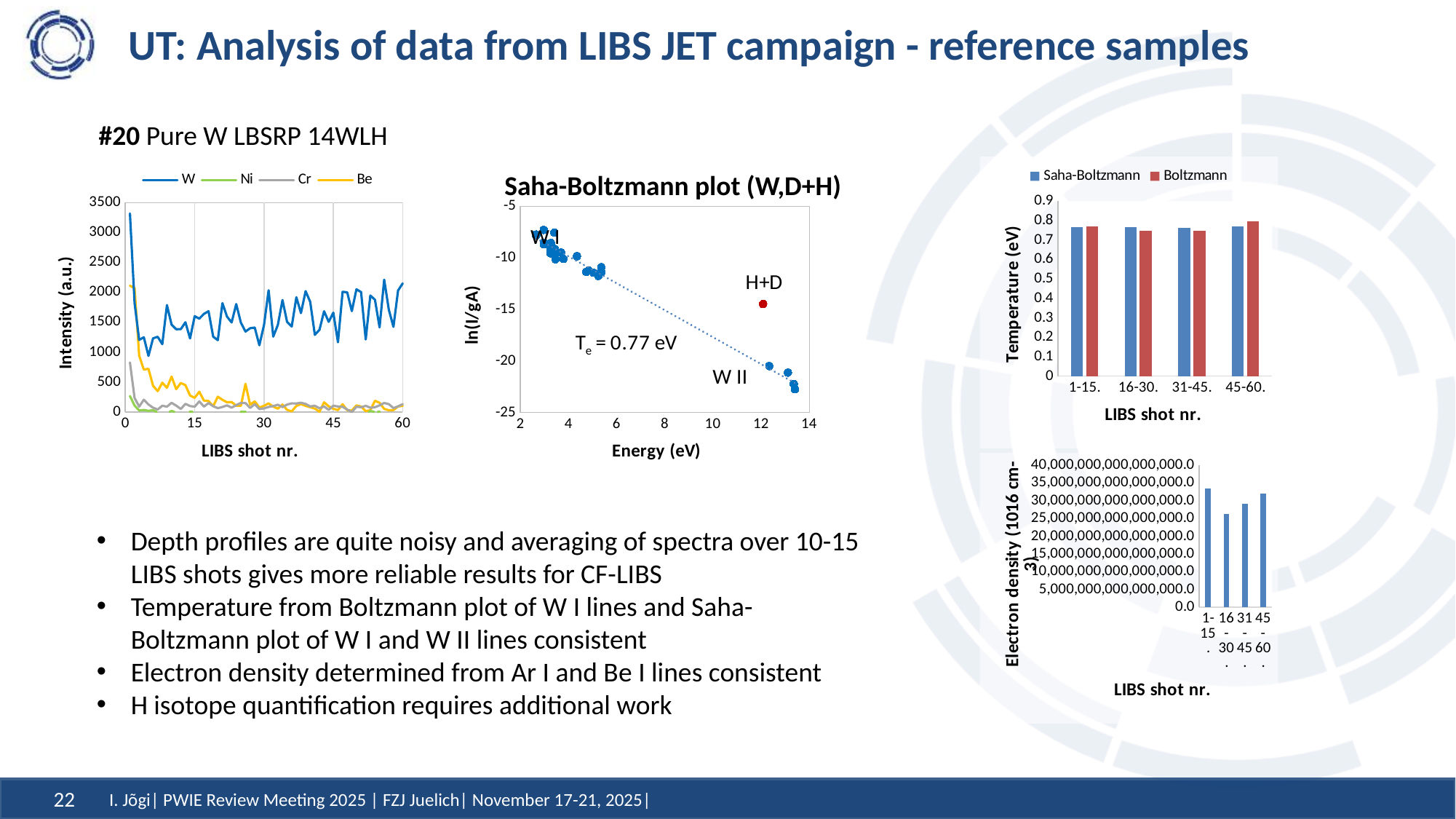
How many series does the legend of the Temperature (eV) bar chart list? 2 In the Temperature (eV) bar chart, is the Saha-Boltzmann value for 1-15. greater or less than 0.7? greater In the top-left intensity line chart, is the Be intensity at LIBS shot 30 greater or less than 500? less In the top-left intensity line chart, is the W intensity at LIBS shot 1 greater or less than 3000? greater How many series does the legend of the top-left intensity line chart list? 4 What kind of chart is the top-left chart with the x axis 'LIBS shot nr.' and y axis 'Intensity (a.u.)'? line chart In the Electron density bar chart, which LIBS shot range has the lowest electron density? 16-30. In the top-left intensity line chart, which series has the highest intensity across the LIBS shots? W What is the x-axis label of the Saha-Boltzmann plot (W,D+H)? Energy (eV) How many LIBS shot ranges are shown on the x axis of the Temperature (eV) bar chart? 4 What electron temperature is annotated on the Saha-Boltzmann plot (W,D+H)? Te = 0.77 eV